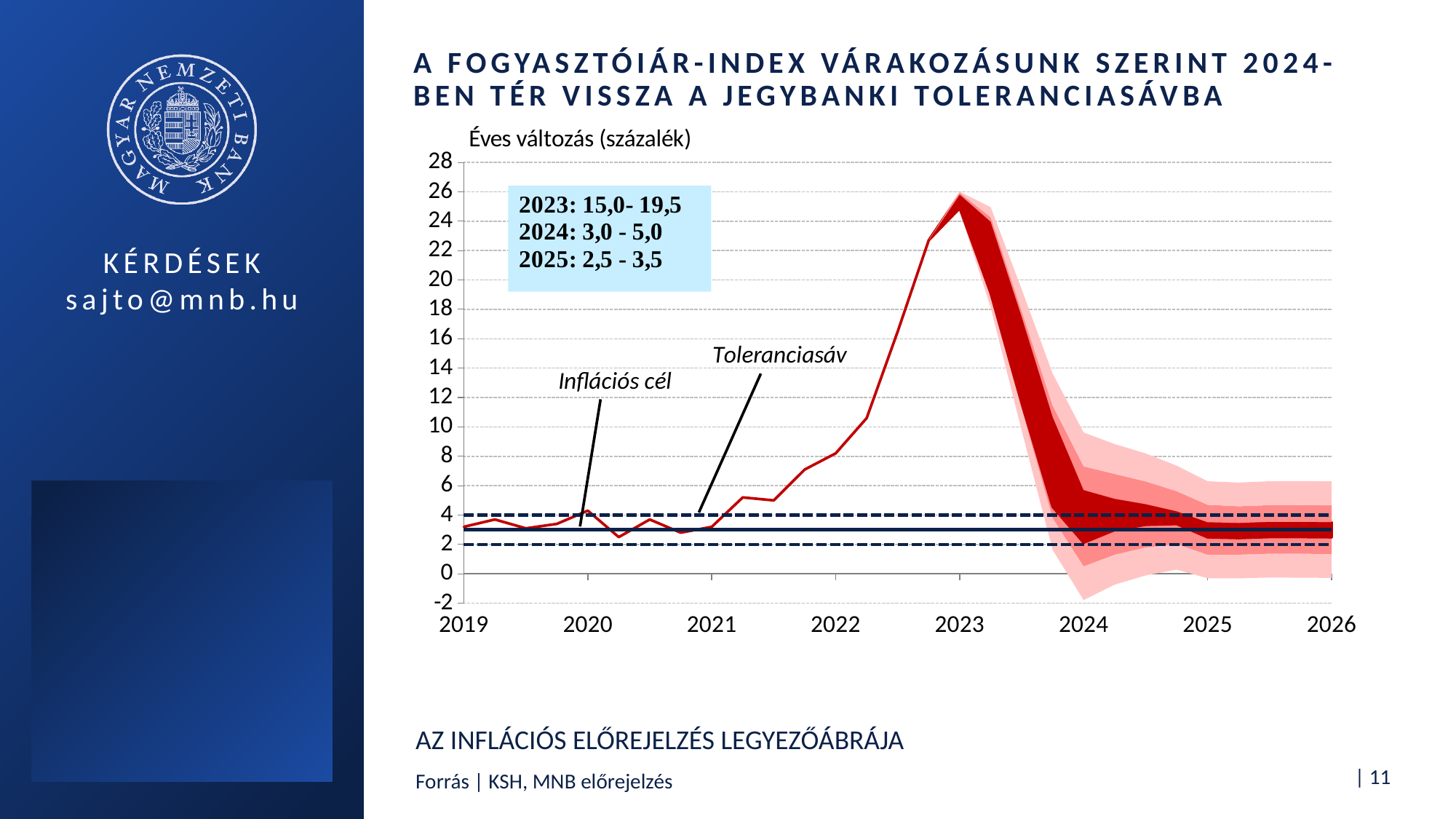
How many years are labelled on the horizontal axis? 8 What kind of chart is shown on the slide? line chart Is the peak value of the inflation line in 2023 greater or less than 24? greater What is the title of the chart? Az inflációs előrejelzés legyezőábrája According to the text box, what is the forecast range for 2025? 2,5 - 3,5 According to the text box, what is the forecast range for 2023? 15,0- 19,5 In which year does the inflation line reach its peak? 2023 Does the inflation line rise or fall between 2021 and 2023? rise Between which two levels is the tolerance band (Toleranciasáv) drawn? 2 and 4 At what level is the inflation target (Inflációs cél) line drawn? 3 What is the label of the vertical axis? Éves változás (százalék) According to the text box, what is the forecast range for 2024? 3,0 - 5,0